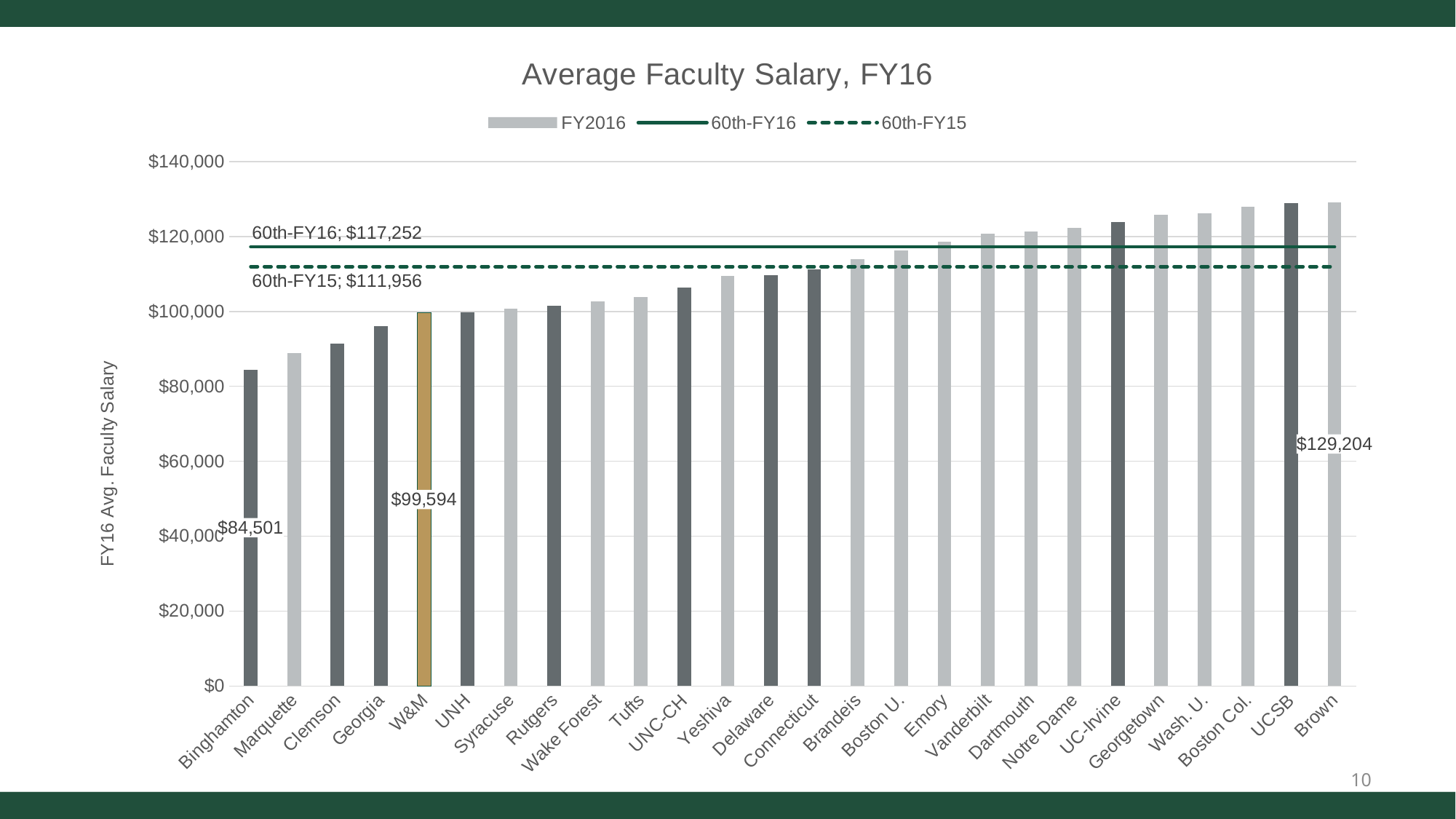
What is the FY2016 average faculty salary for Binghamton? $84,501 What is the FY2016 average faculty salary for W&M? $99,594 How much higher is the 60th-FY16 value than the 60th-FY15 value? $5,296 Is the FY2016 value for Georgetown greater or less than $120,000? greater Is the FY2016 value for Georgia greater or less than $100,000? less What is the difference between Brown's and Binghamton's FY2016 average faculty salaries? $44,703 What value is shown for the 60th-FY15 line? $111,956 What value is shown for the 60th-FY16 line? $117,252 Which institution has the lowest FY2016 average faculty salary? Binghamton How many institutions are shown on the x axis? 26 What is the FY2016 average faculty salary for Brown? $129,204 Which is larger, W&M's FY2016 salary or the 60th-FY16 value? 60th-FY16